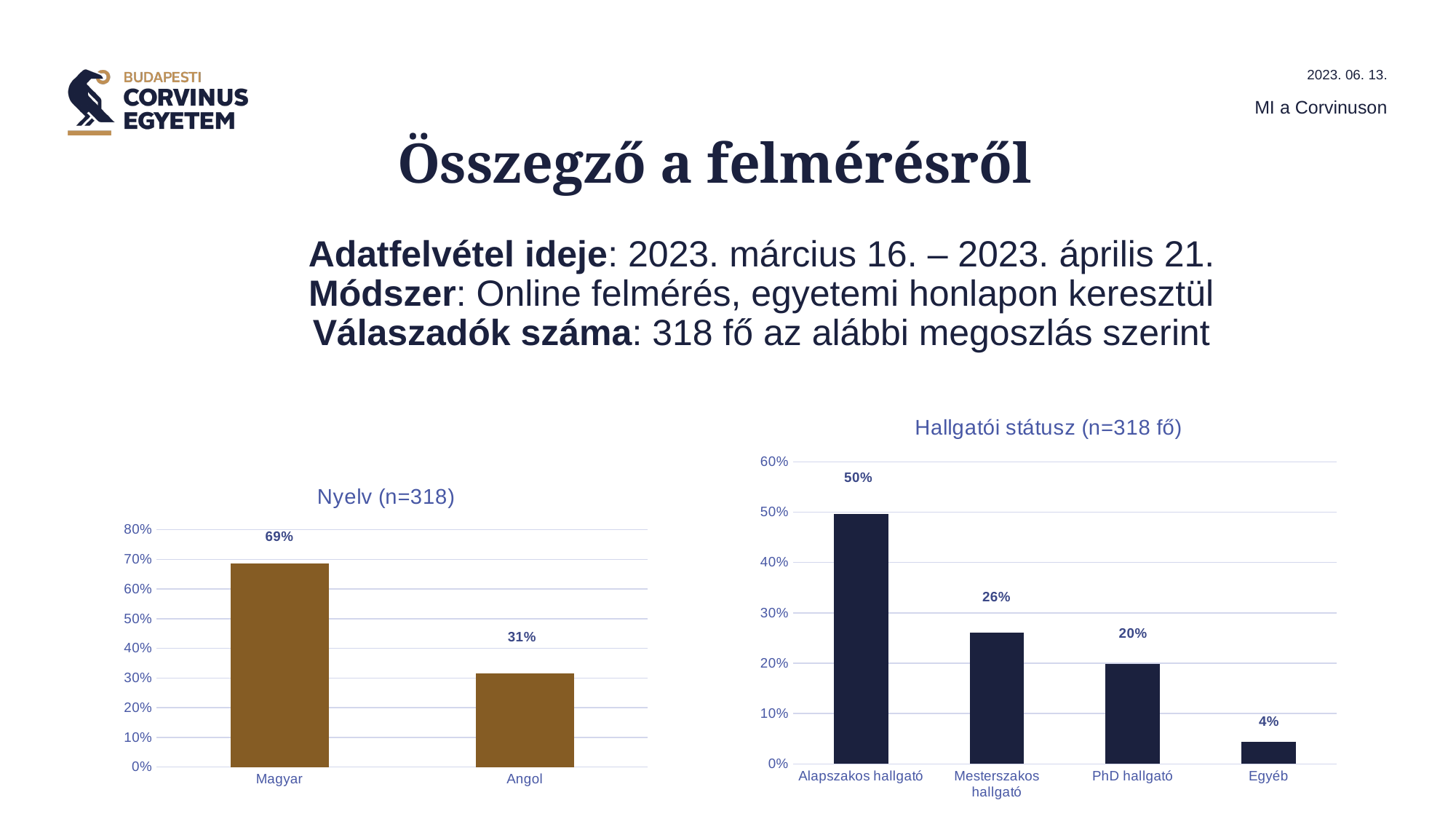
In the 'Hallgatói státusz (n=318 fő)' chart, which category has the lowest value? Egyéb In the 'Hallgatói státusz (n=318 fő)' chart, do the values rise or fall from left to right? Fall In the 'Nyelv (n=318)' chart, how many categories are shown? 2 What kind of chart is the 'Nyelv (n=318)' chart? Bar chart In the 'Hallgatói státusz (n=318 fő)' chart, which category has the highest value? Alapszakos hallgató In the 'Hallgatói státusz (n=318 fő)' chart, what is the value for PhD hallgató? 20% In the 'Hallgatói státusz (n=318 fő)' chart, what is the value for Alapszakos hallgató? 50% In the 'Nyelv (n=318)' chart, what is the value for Angol? 31% In the 'Nyelv (n=318)' chart, what is the value for Magyar? 69% In the 'Hallgatói státusz (n=318 fő)' chart, what is the difference between Mesterszakos hallgató and PhD hallgató? 6% In the 'Hallgatói státusz (n=318 fő)' chart, how many categories are shown? 4 In the 'Nyelv (n=318)' chart, what is the difference between the Magyar and Angol values? 38%